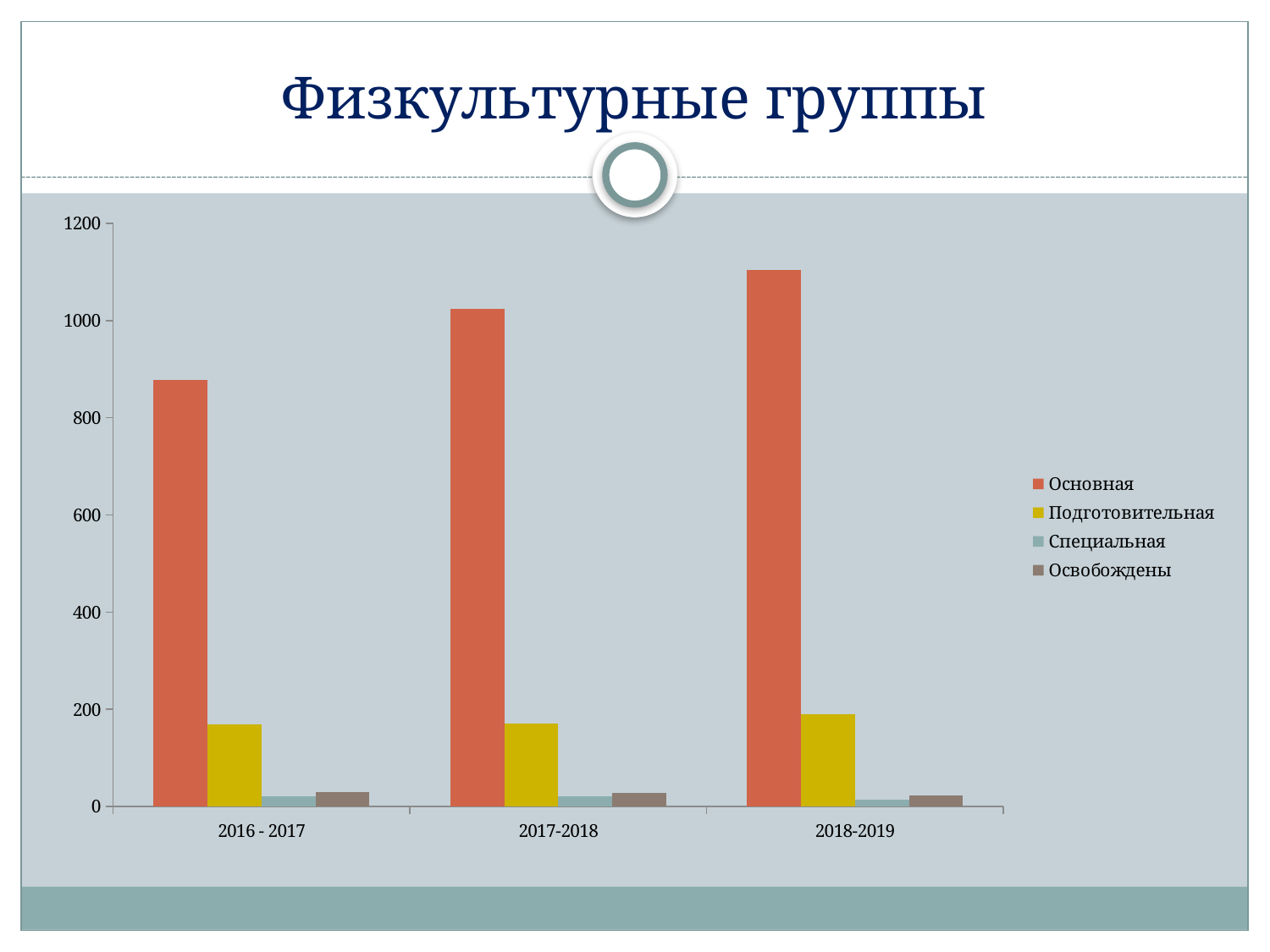
Is the value for Основная in 2018-2019 greater or less than 1000? greater In which year is the value for Основная the lowest? 2016 - 2017 What is the title of the chart? Физкультурные группы Is the value for Основная in 2016 - 2017 greater or less than 800? greater How many school-year categories are shown on the x axis? 3 Which series is listed first in the legend? Основная Which is larger in 2017-2018, Основная or Подготовительная? Основная In which year is the value for Основная the highest? 2018-2019 How many series does the legend list? 4 What kind of chart is shown on the slide? bar chart Does the value for Основная rise or fall from 2016 - 2017 to 2018-2019? rise